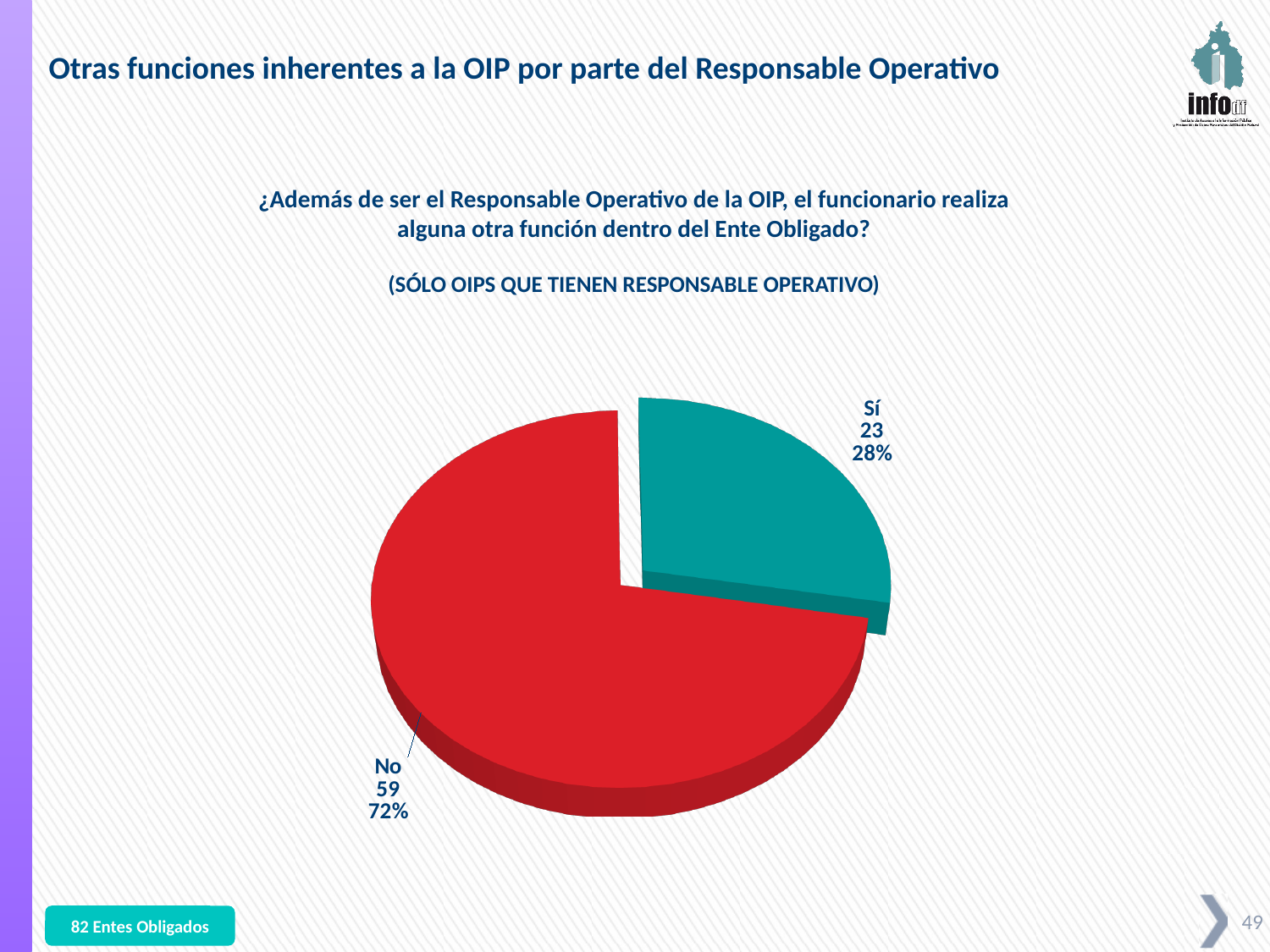
Which slice is the largest? No What is the total of the two slice counts? 82 How many slices does the pie chart have? 2 What kind of chart is shown on the slide? pie chart What percentage share does the "No" slice represent? 72% What is the difference between the counts for "No" and "Sí"? 36 What colour is the "Sí" slice? teal What percentage share does the "Sí" slice represent? 28% Which slice is the smallest? Sí What is the count for the "No" slice? 59 What is the count for the "Sí" slice? 23 Which is larger, the "Sí" slice or the "No" slice? No